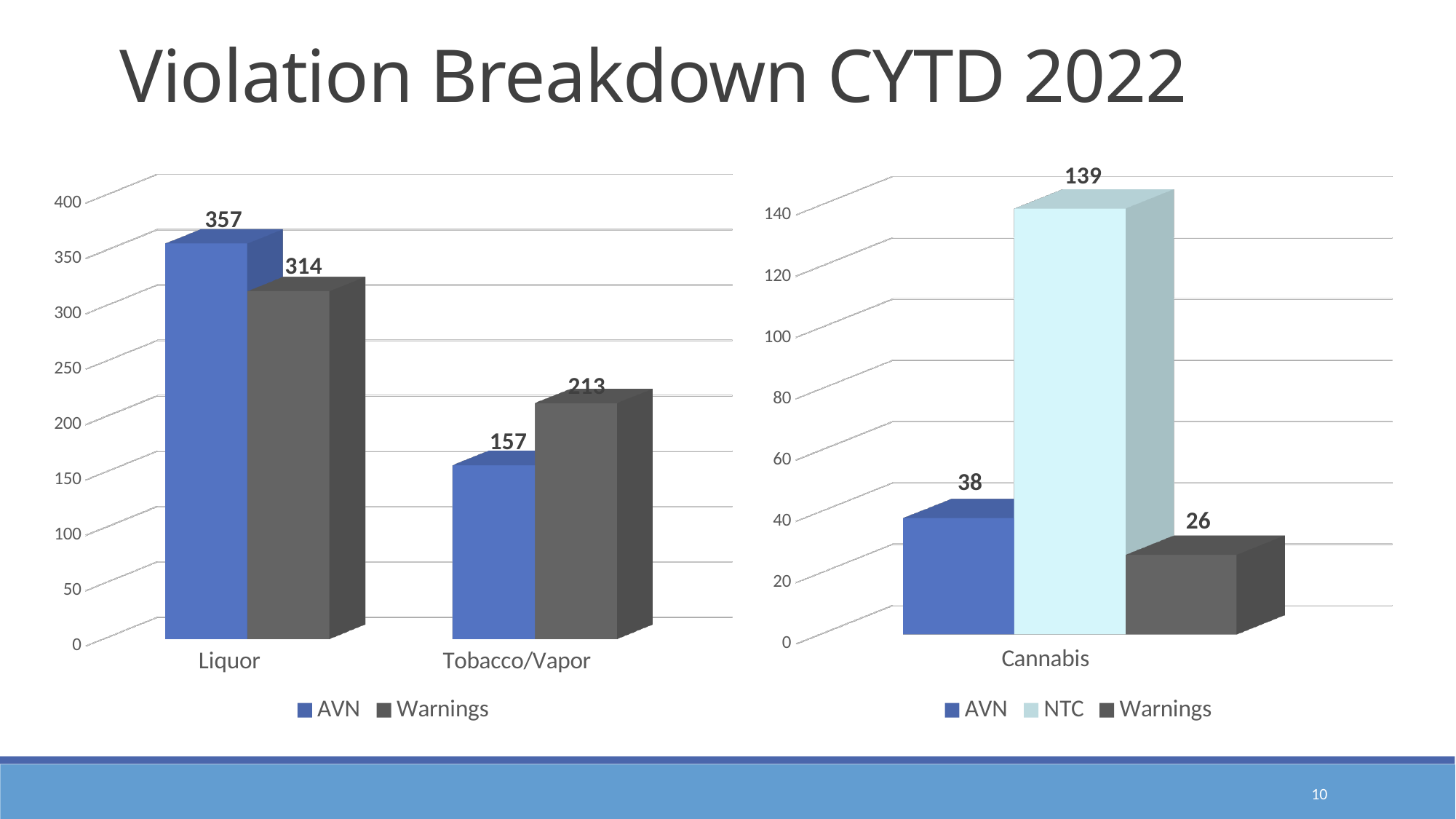
In the right chart, what is the NTC value for Cannabis? 139 In the left chart, which category has the highest AVN value? Liquor What kind of chart is the left chart? Bar chart In the right chart, what is the difference between the NTC and AVN values for Cannabis? 101 In the left chart, what is the AVN value for Liquor? 357 How many categories are shown on the x axis of the left chart? 2 How many series does the legend of the right chart list? 3 In the left chart, which is larger for Tobacco/Vapor: AVN or Warnings? Warnings In the right chart, which series has the lowest value for Cannabis? Warnings In the right chart, what is the Warnings value for Cannabis? 26 In the left chart, what is the difference between the AVN and Warnings values for Liquor? 43 In the left chart, what is the Warnings value for Tobacco/Vapor? 213